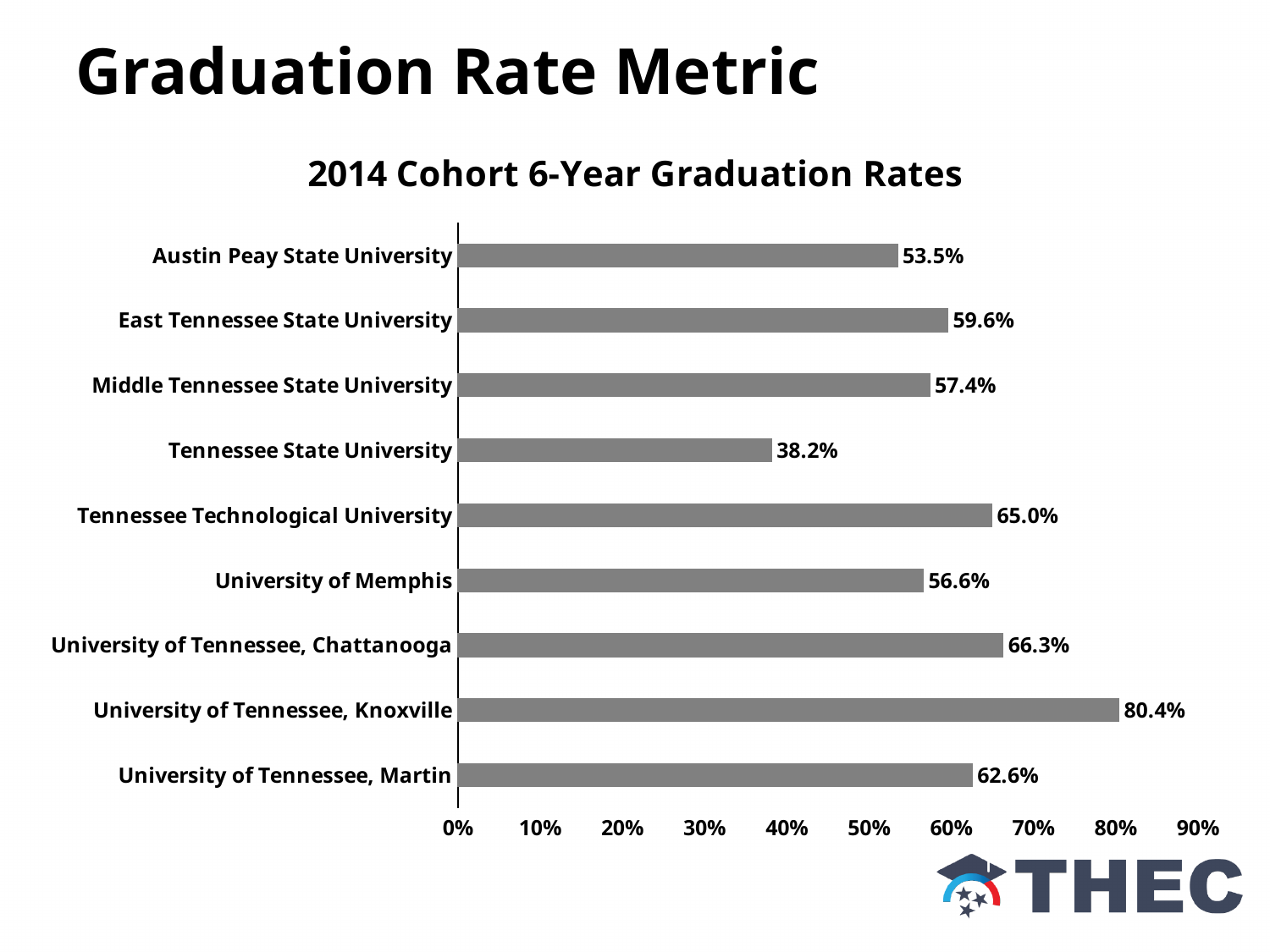
How many universities are shown in the chart? 9 What is the 6-year graduation rate for University of Memphis? 56.6% Is the graduation rate for Tennessee State University greater or less than 40%? less What is the difference in graduation rate between East Tennessee State University and Middle Tennessee State University? 2.2% Which university has the highest 6-year graduation rate? University of Tennessee, Knoxville What is the 6-year graduation rate for Tennessee Technological University? 65.0% What is the title of the chart? 2014 Cohort 6-Year Graduation Rates Which university has the lowest 6-year graduation rate? Tennessee State University What is the 6-year graduation rate for Austin Peay State University? 53.5% What kind of chart is used to show the graduation rates? bar chart What is the difference in graduation rate between University of Tennessee, Knoxville and Tennessee State University? 42.2% Which has a higher graduation rate, University of Tennessee, Chattanooga or University of Tennessee, Martin? University of Tennessee, Chattanooga